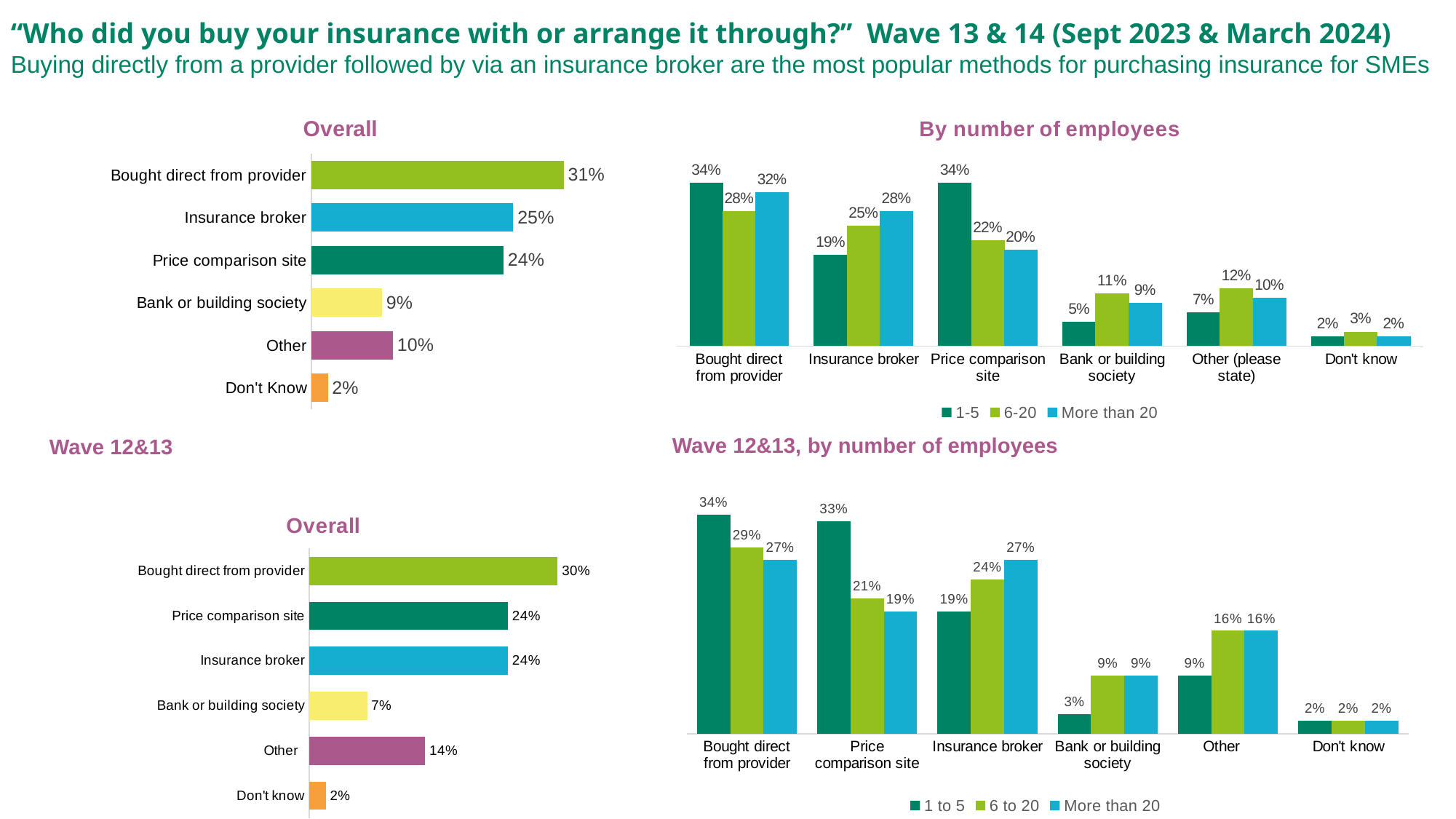
In the top-right 'By number of employees' chart, what is the value for the 6-20 series for Price comparison site? 22% In the top-left 'Overall' chart, what is the difference between Bought direct from provider and Price comparison site? 7% What type of chart is the top-left 'Overall' chart? Bar chart In the top-left 'Overall' chart, what is the value for Insurance broker? 25% In the bottom-right 'Wave 12&13, by number of employees' chart, what is the difference between the More than 20 and 1 to 5 series for Insurance broker? 8% In the top-left 'Overall' chart, which category has the highest value? Bought direct from provider In the top-right 'By number of employees' chart, which is larger for Insurance broker: the 1-5 series or the More than 20 series? More than 20 In the bottom-left 'Wave 12&13 Overall' chart, which category has the lowest value? Don't know In the bottom-left 'Wave 12&13 Overall' chart, what is the value for Other? 14% In the top-right 'By number of employees' chart, how many series does the legend list? 3 In the bottom-left 'Wave 12&13 Overall' chart, how many categories are shown? 6 In the bottom-right 'Wave 12&13, by number of employees' chart, what is the value for the 1 to 5 series for Bank or building society? 3%